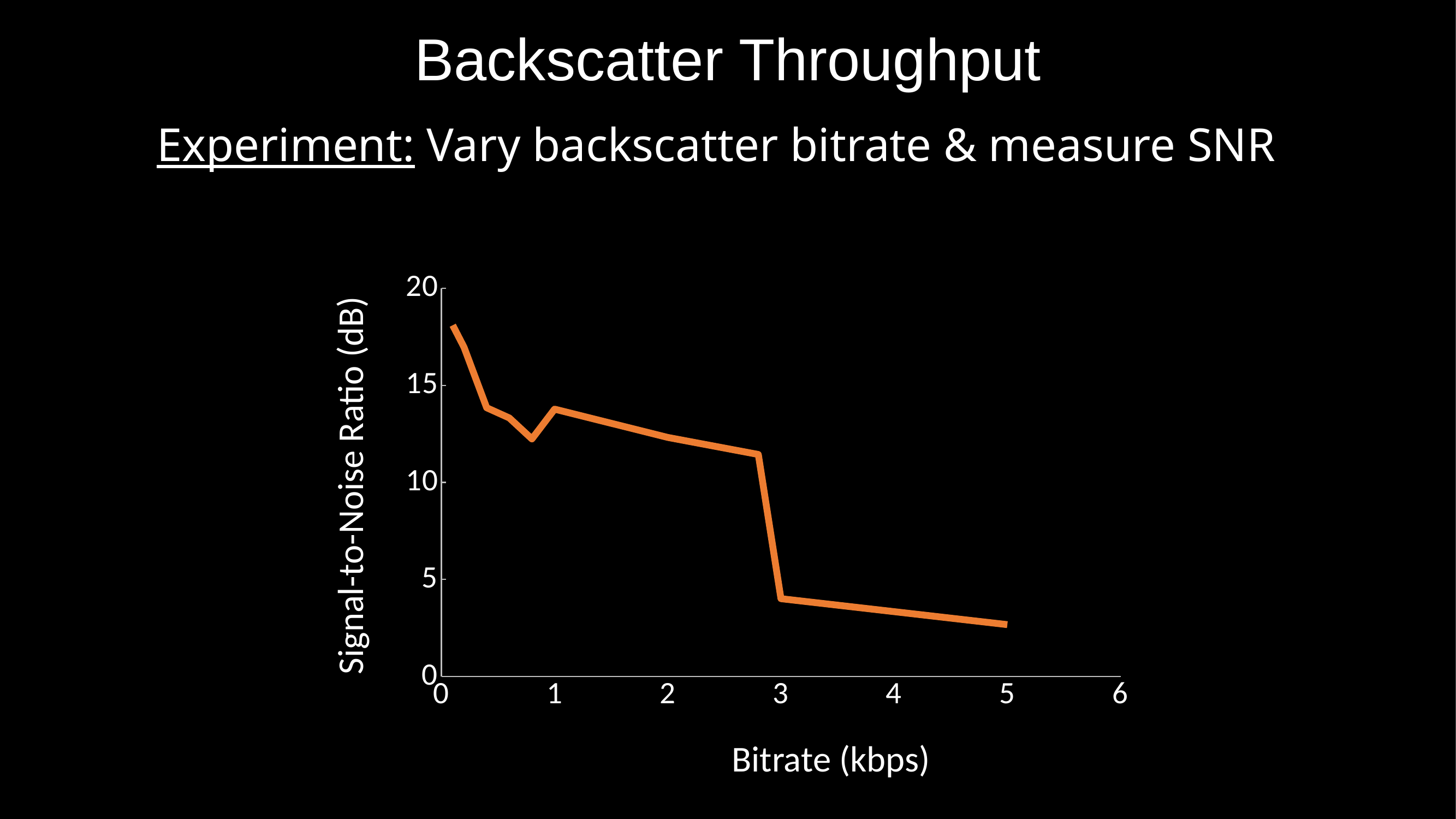
Does the signal-to-noise ratio generally rise or fall as bitrate increases along the x axis? fall What kind of chart is shown on the slide? line chart What is the highest value shown on the x axis? 6 Which has the higher signal-to-noise ratio: a bitrate of 2 kbps or a bitrate of 4 kbps? 2 kbps Is the signal-to-noise ratio at a bitrate of 2 kbps greater or less than 10 dB? greater What is the label of the y axis? Signal-to-Noise Ratio (dB) Is the signal-to-noise ratio at a bitrate of 1 kbps greater or less than 10 dB? greater Is the signal-to-noise ratio at a bitrate of 5 kbps greater or less than 5 dB? less What is the title of the slide containing the chart? Backscatter Throughput How many lines (series) are plotted on the chart? 1